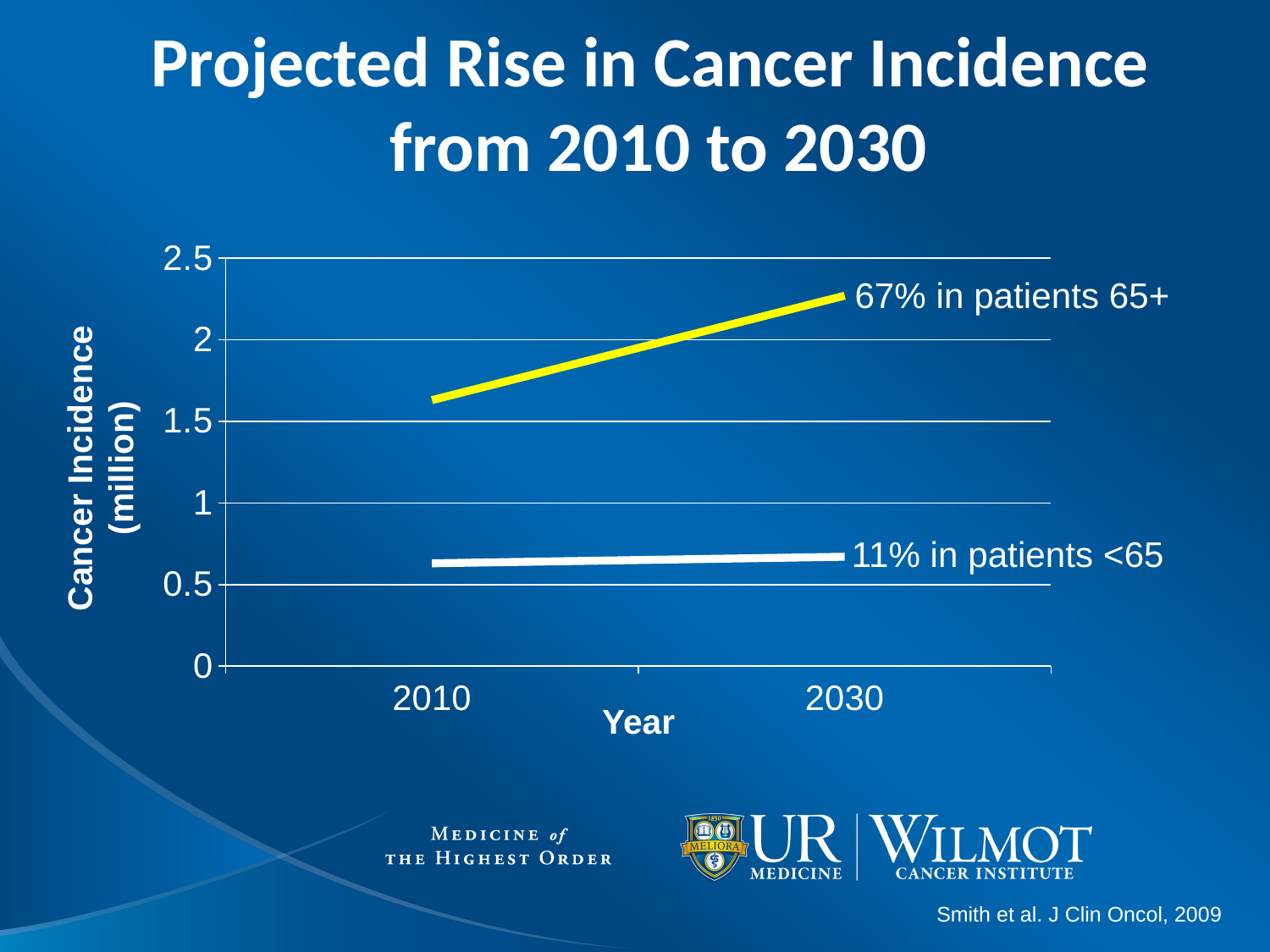
Is the cancer incidence for patients 65+ in 2010 greater or less than 1.5 million? greater What is the label on the vertical axis? Cancer Incidence (million) How many lines are plotted on the chart? 2 Is the cancer incidence for patients 65+ in 2030 greater or less than 2 million? greater Is the cancer incidence for patients <65 in 2010 greater or less than 1 million? less What percentage rise is annotated for patients <65? 11% What is the title of the chart? Projected Rise in Cancer Incidence from 2010 to 2030 What kind of chart is shown on the slide? line chart Does the line for patients 65+ rise or fall from 2010 to 2030? rise How many years are labelled on the x axis? 2 Which group has the higher cancer incidence in 2030, patients 65+ or patients <65? patients 65+